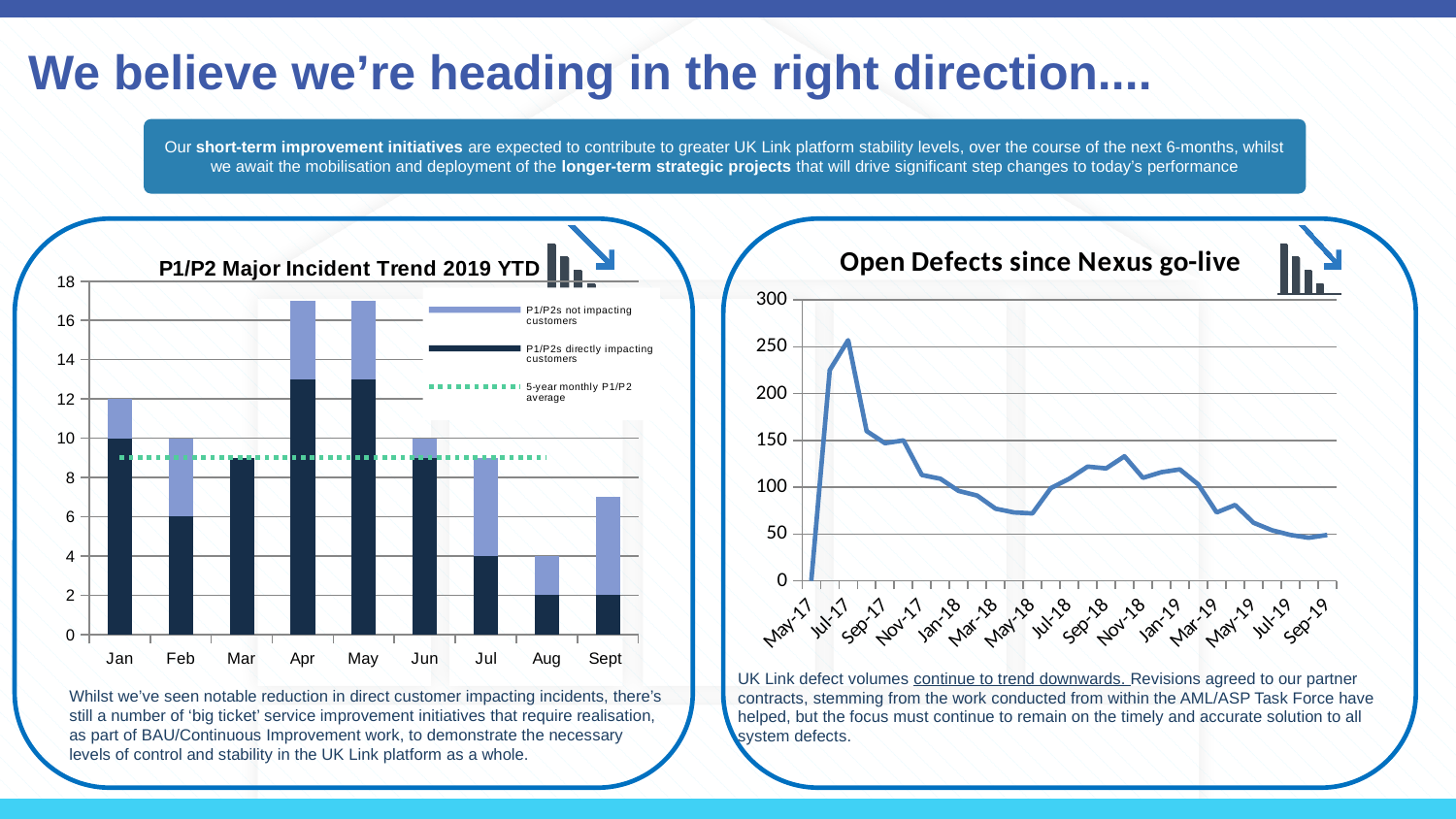
In the Open Defects since Nexus go-live chart, do the values generally rise or fall from Jul-17 to Sep-19? Fall In the Open Defects since Nexus go-live chart, is the value for Sep-19 greater or less than 100? less In the P1/P2 Major Incident Trend 2019 YTD chart, which month has the lowest total bar? Aug What kind of chart is the Open Defects since Nexus go-live chart? Line chart In the P1/P2 Major Incident Trend 2019 YTD chart, how many months are shown on the x axis? 9 In the Open Defects since Nexus go-live chart, is the peak value greater or less than 250? greater In the P1/P2 Major Incident Trend 2019 YTD chart, what is the value of P1/P2s directly impacting customers for Jul? 4 What kind of chart is the P1/P2 Major Incident Trend 2019 YTD chart? Combination bar and line chart (stacked bars with a dotted average line) In the P1/P2 Major Incident Trend 2019 YTD chart, which has the larger total bar, Jan or Feb? Jan In the P1/P2 Major Incident Trend 2019 YTD chart, what is the total height of the stacked bar for Jan? 12 How many series does the legend of the P1/P2 Major Incident Trend 2019 YTD chart list? 3 In the P1/P2 Major Incident Trend 2019 YTD chart, is the total bar for Apr greater or less than 16? greater